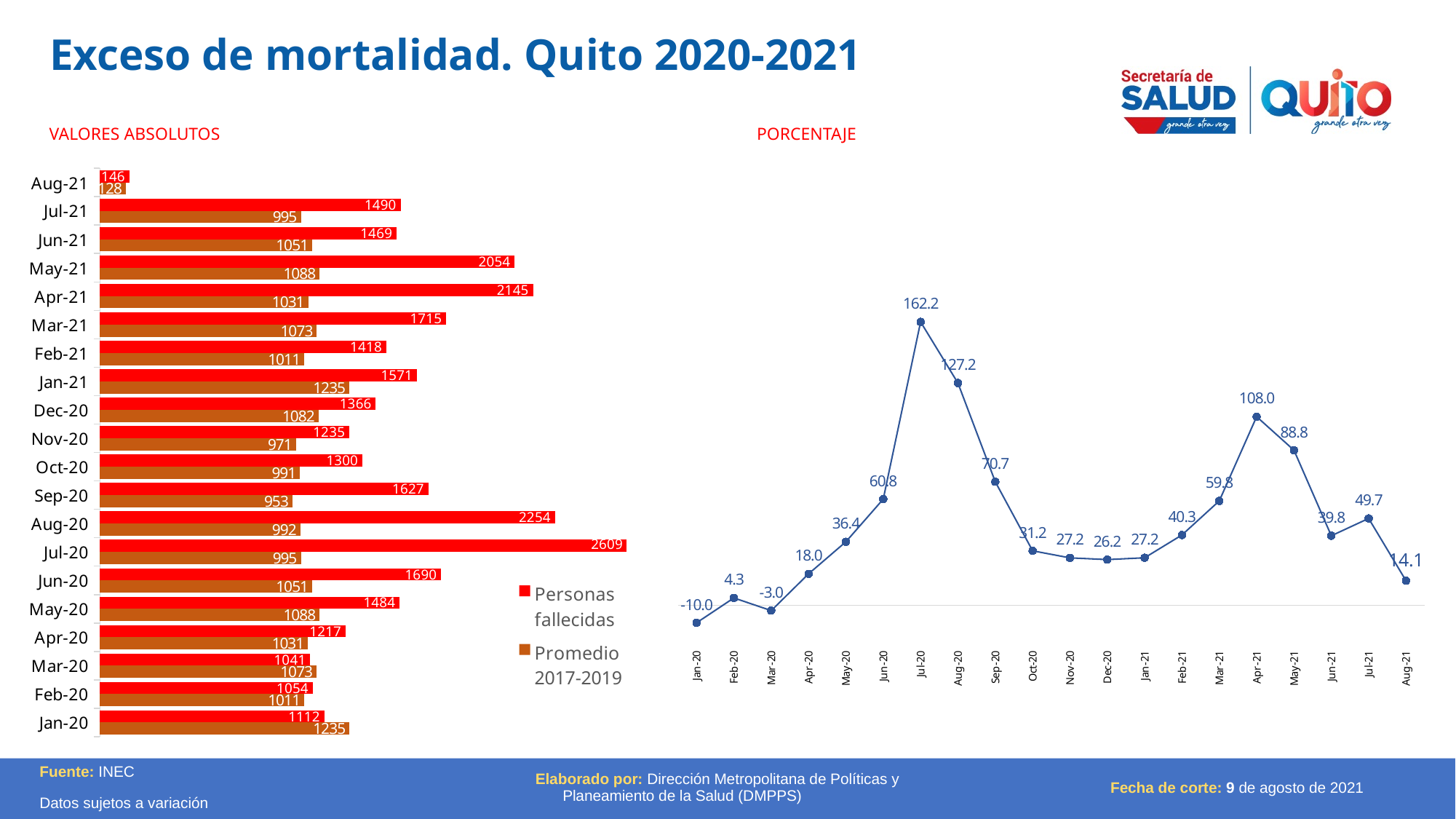
What kind of chart is the VALORES ABSOLUTOS chart? Bar chart In the PORCENTAJE chart, what is the value for Jul-20? 162.2 In the VALORES ABSOLUTOS chart, what is the Promedio 2017-2019 value for Jan-21? 1235 In the PORCENTAJE chart, which month has the lowest value? Jan-20 In the PORCENTAJE chart, what is the difference between the values for Jul-20 and Aug-20? 35.0 In the VALORES ABSOLUTOS chart, which month has the lowest Personas fallecidas value? Aug-21 In the VALORES ABSOLUTOS chart, which is larger for Jan-20: Personas fallecidas or Promedio 2017-2019? Promedio 2017-2019 How many series does the legend of the VALORES ABSOLUTOS chart list? 2 In the VALORES ABSOLUTOS chart, what is the value of Personas fallecidas for Jul-20? 2609 How many data points are plotted in the PORCENTAJE chart? 20 In the VALORES ABSOLUTOS chart, what is the difference between Personas fallecidas and Promedio 2017-2019 for Apr-21? 1114 In the VALORES ABSOLUTOS chart, which month has the highest Personas fallecidas value? Jul-20